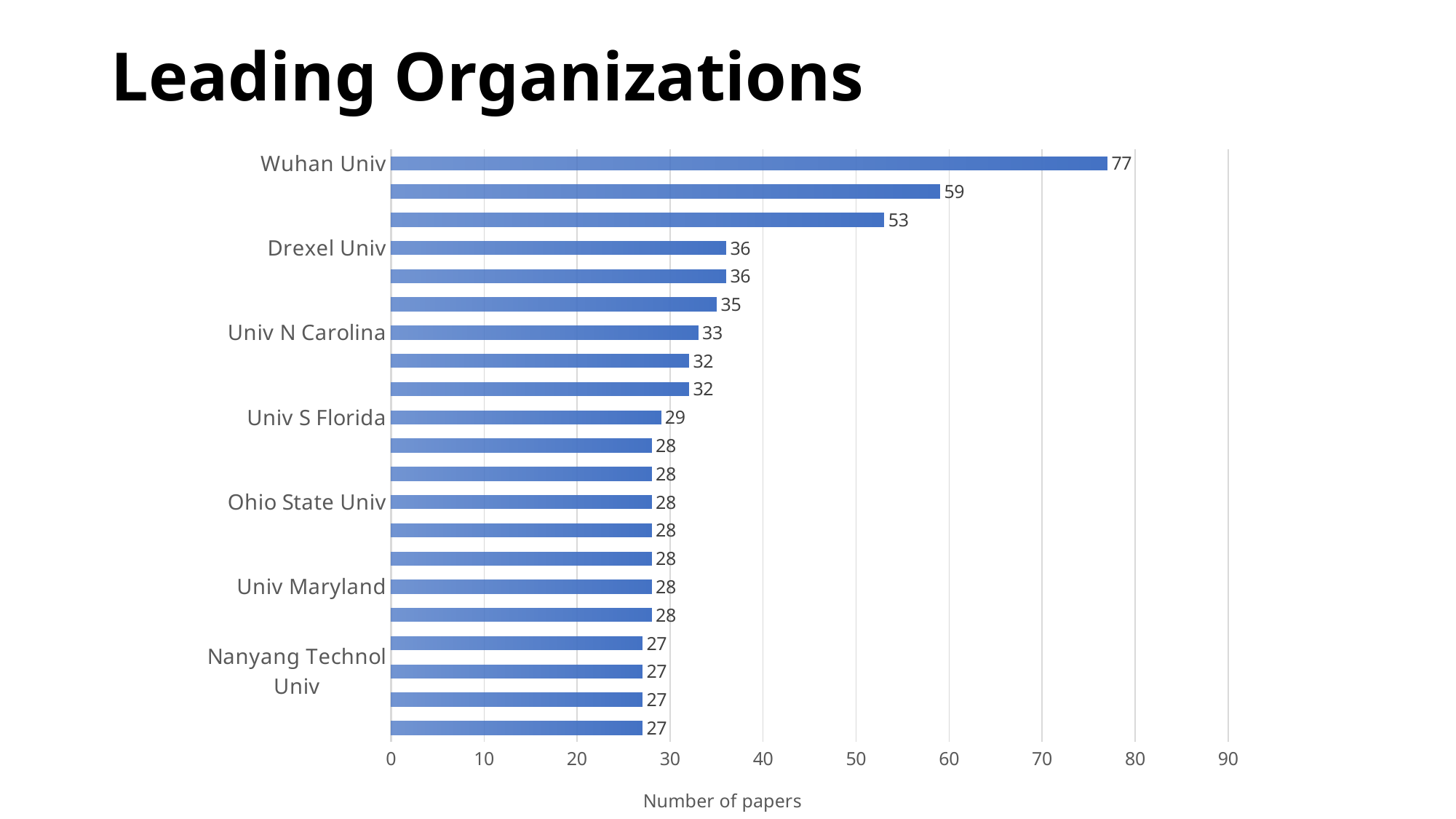
What kind of chart is shown on the slide? Bar chart What is the title of the horizontal axis? Number of papers How many papers does Wuhan Univ have? 77 What is the value for Nanyang Technol Univ? 27 What is the number of papers for Univ N Carolina? 33 What is the difference in number of papers between Wuhan Univ and Drexel Univ? 41 What is the value for Drexel Univ? 36 Which organization has the highest number of papers? Wuhan Univ Which has more papers, Drexel Univ or Univ N Carolina? Drexel Univ What is the value shown for Univ S Florida? 29 How many bars are plotted in the chart? 21 How many papers does Ohio State Univ have? 28